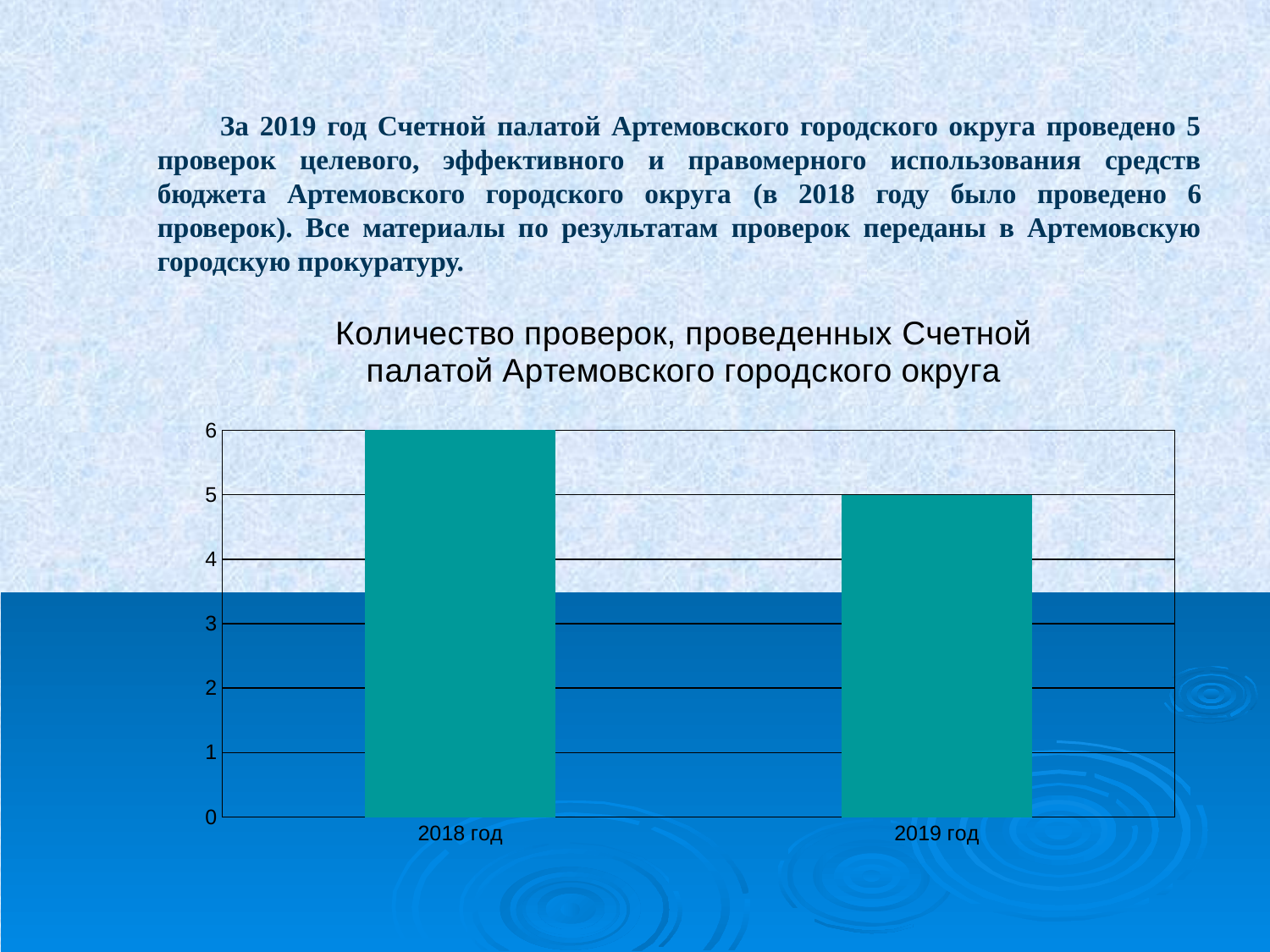
What is the title of the chart? Количество проверок, проведенных Счетной палатой Артемовского городского округа What type of chart is shown on the slide? bar chart What is the value for 2018 год? 6 Do the values rise or fall from 2018 год to 2019 год? fall Is the value for 2019 год greater or less than 3? greater What is the difference between the values for 2018 год and 2019 год? 1 What is the value for 2019 год? 5 Which year has the highest value? 2018 год Which is larger, the value for 2018 год or the value for 2019 год? 2018 год Which year has the lowest value? 2019 год What is the maximum value shown on the vertical axis? 6 How many categories are shown on the x axis of the chart? 2